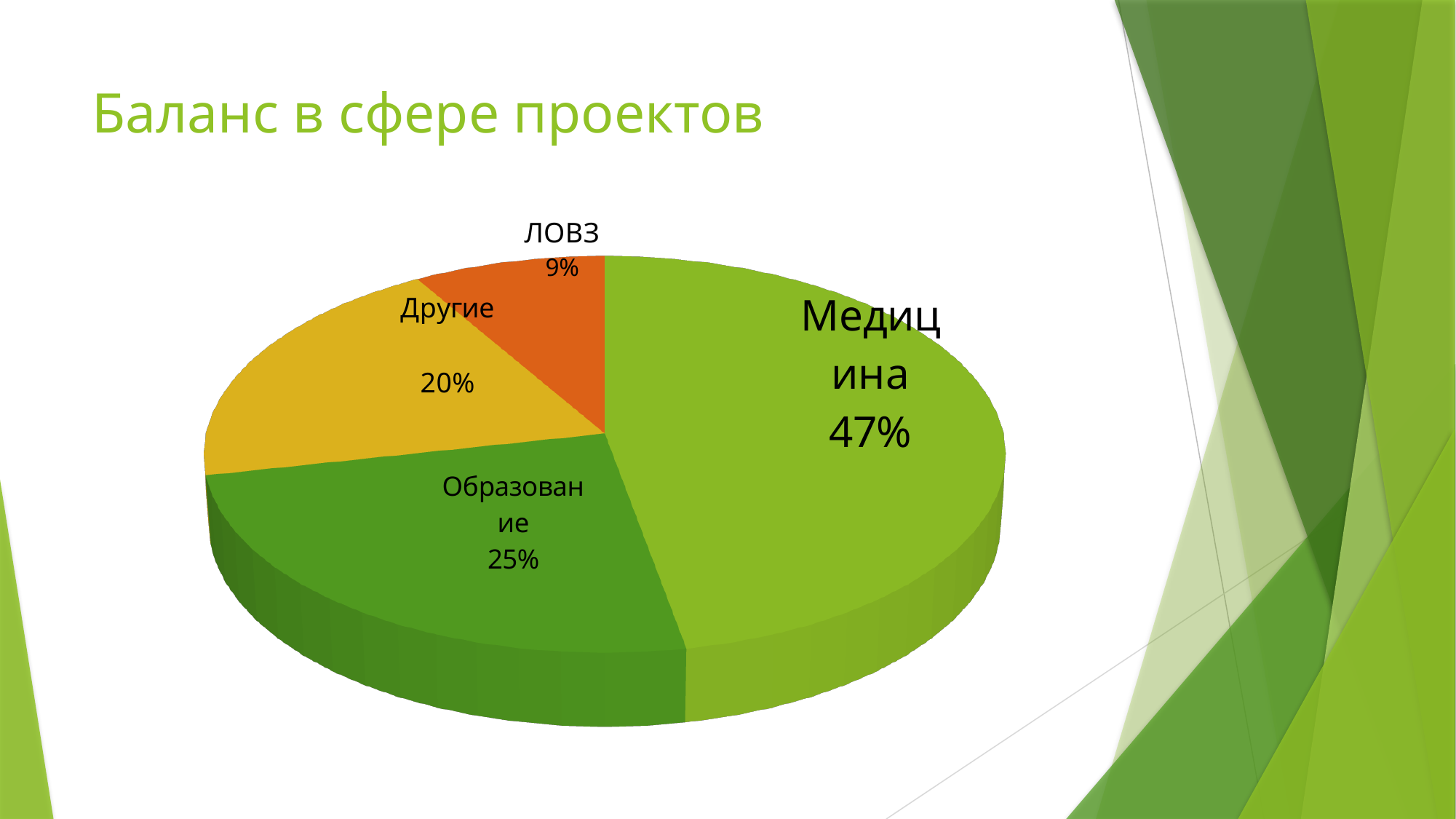
What is the difference in percentage points between Другие and ЛОВЗ? 11 Which category has the smallest share of the pie? ЛОВЗ How many slices does the pie chart have? 4 What is the title of the slide containing the chart? Баланс в сфере проектов What share of the pie does Медицина have? 47% Which category has the largest share of the pie? Медицина What is the difference in percentage points between Медицина and Образование? 22 What share of the pie does ЛОВЗ have? 9% What share of the pie does Образование have? 25% What kind of chart is shown on the slide? Pie chart Which is larger, the share for Образование or the share for Другие? Образование What share of the pie does Другие have? 20%